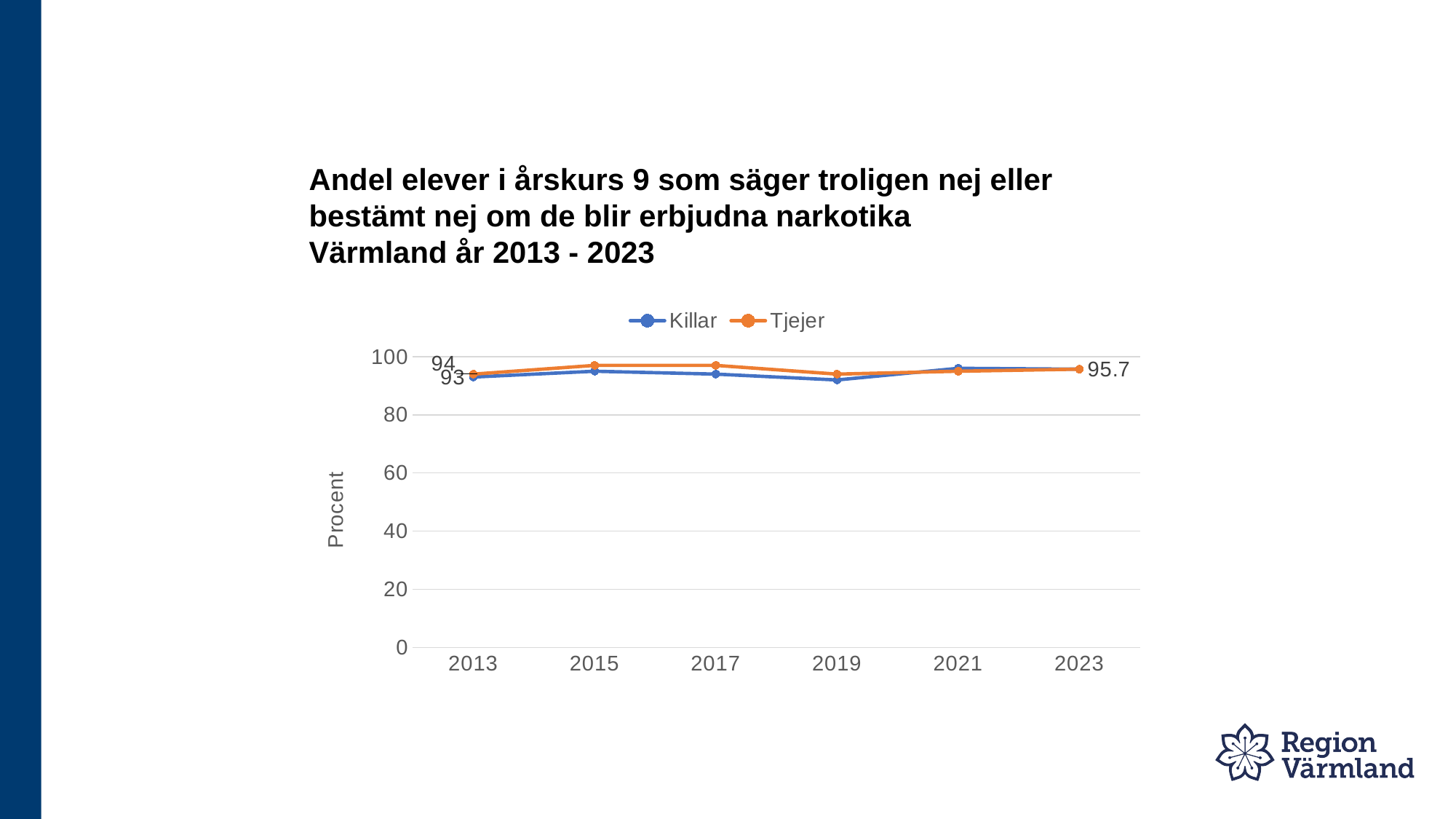
What kind of chart is shown on the slide? line chart How many series does the legend list? 2 What is the value for Tjejer in 2013? 94 In 2017, which series has the higher value, Killar or Tjejer? Tjejer What is the title of the y axis? Procent How many years are plotted along the x axis? 6 Is the value for Killar in 2019 greater or less than 80? greater What is the value for Killar in 2013? 93 In 2013, which series has the higher value, Killar or Tjejer? Tjejer What is the difference between the Tjejer and Killar values in 2013? 1 What are the two series named in the legend? Killar and Tjejer What value is labelled at the 2023 data point? 95.7